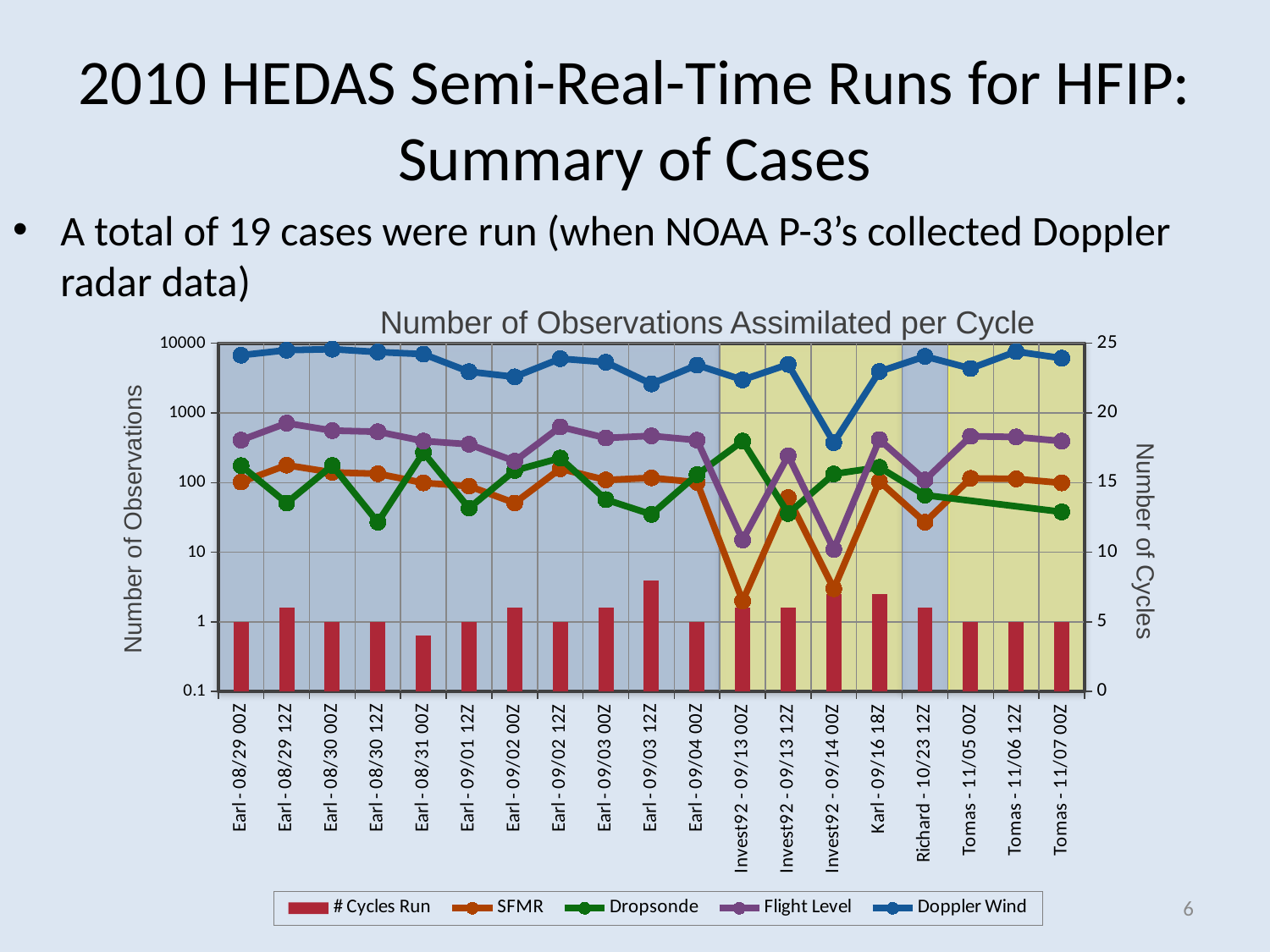
How many cycles were run for Earl - 08/29 00Z according to the bar? 5 For which case is the SFMR value lowest? Invest92 - 09/13 00Z Is the Doppler Wind value for Invest92 - 09/14 00Z greater or less than 1000? less What kind of chart is shown on the slide? Combination bar and line chart Which case has the lowest number of cycles run? Earl - 08/31 00Z For which case is the Doppler Wind value lowest? Invest92 - 09/14 00Z How many cases (categories) are shown along the x axis of the chart? 19 What is the title of the chart? Number of Observations Assimilated per Cycle How many series does the chart legend list? 5 Which case has the highest number of cycles run? Earl - 09/03 12Z What is the title of the right-hand vertical axis? Number of Cycles At Earl - 08/29 00Z, which is larger: the Doppler Wind value or the SFMR value? Doppler Wind